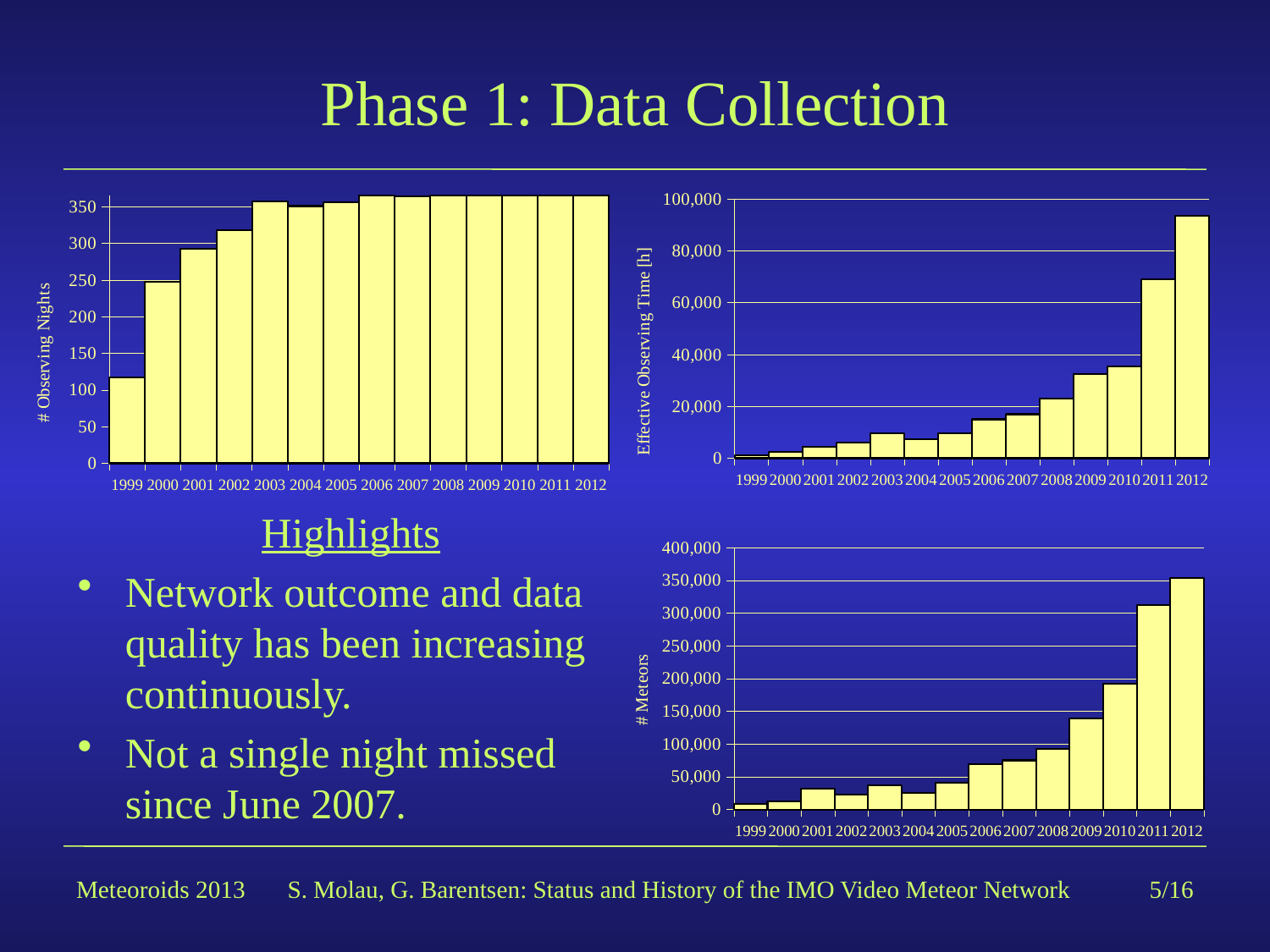
In the # Meteors chart (bottom right), is the value for 2009 greater or less than 100,000? greater In the # Observing Nights chart (top left), is the value for 1999 greater or less than 100? greater What type of chart is the # Meteors chart (bottom right)? bar chart In the # Observing Nights chart (top left), which year has the lowest number of observing nights? 1999 In the # Meteors chart (bottom right), do the values generally rise or fall from 1999 to 2012? rise In the Effective Observing Time [h] chart (top right), is the value for 2011 greater or less than 60,000? greater In the Effective Observing Time [h] chart (top right), which year has the highest value? 2012 In the # Observing Nights chart (top left), how many years are shown on the x axis? 14 In the # Meteors chart (bottom right), which year has the highest number of meteors? 2012 In the Effective Observing Time [h] chart (top right), which is larger, the value for 2009 or the value for 2006? 2009